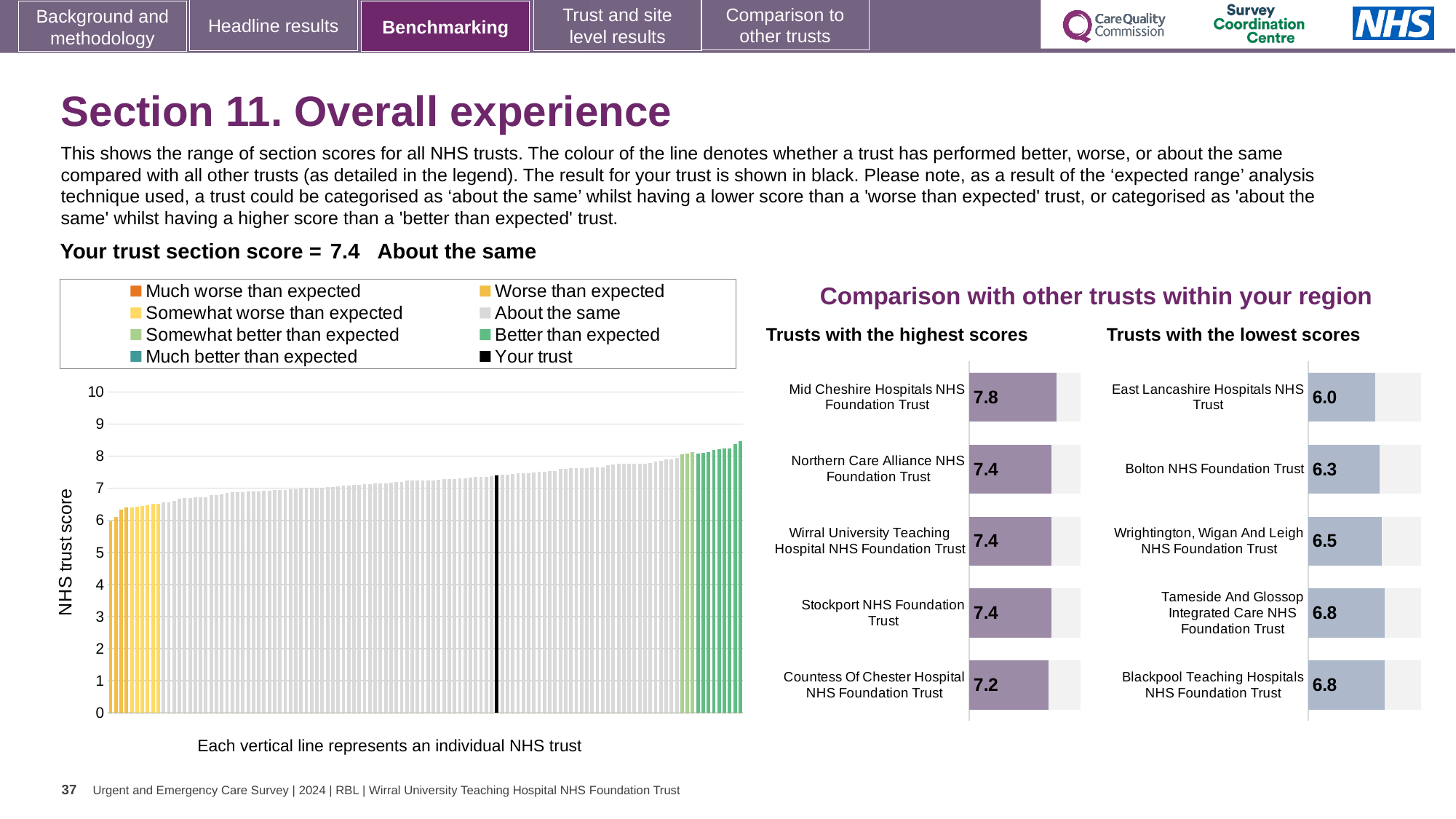
In the 'Trusts with the lowest scores' chart, which has the larger score: Bolton NHS Foundation Trust or Wrightington, Wigan And Leigh NHS Foundation Trust? Wrightington, Wigan And Leigh NHS Foundation Trust In the 'Trusts with the lowest scores' chart, what is the score for Bolton NHS Foundation Trust? 6.3 In the 'Trusts with the highest scores' chart, which trust has the highest score? Mid Cheshire Hospitals NHS Foundation Trust In the 'Trusts with the lowest scores' chart, how much higher is Blackpool Teaching Hospitals NHS Foundation Trust's score than East Lancashire Hospitals NHS Trust's score? 0.8 In the 'Trusts with the lowest scores' chart, which trust has the lowest score? East Lancashire Hospitals NHS Trust How many trusts are shown in the 'Trusts with the highest scores' chart? 5 How many entries does the legend of the NHS trust score chart on the left list? 8 In the NHS trust score chart on the left, is the value of the leftmost bar greater or less than 5? greater In the 'Trusts with the highest scores' chart, what is the score for Mid Cheshire Hospitals NHS Foundation Trust? 7.8 What kind of chart is the NHS trust score chart on the left of the slide? Bar chart In the 'Trusts with the highest scores' chart, what is the difference between the scores of Mid Cheshire Hospitals NHS Foundation Trust and Countess Of Chester Hospital NHS Foundation Trust? 0.6 In the NHS trust score chart on the left, do the values rise or fall from left to right? Rise